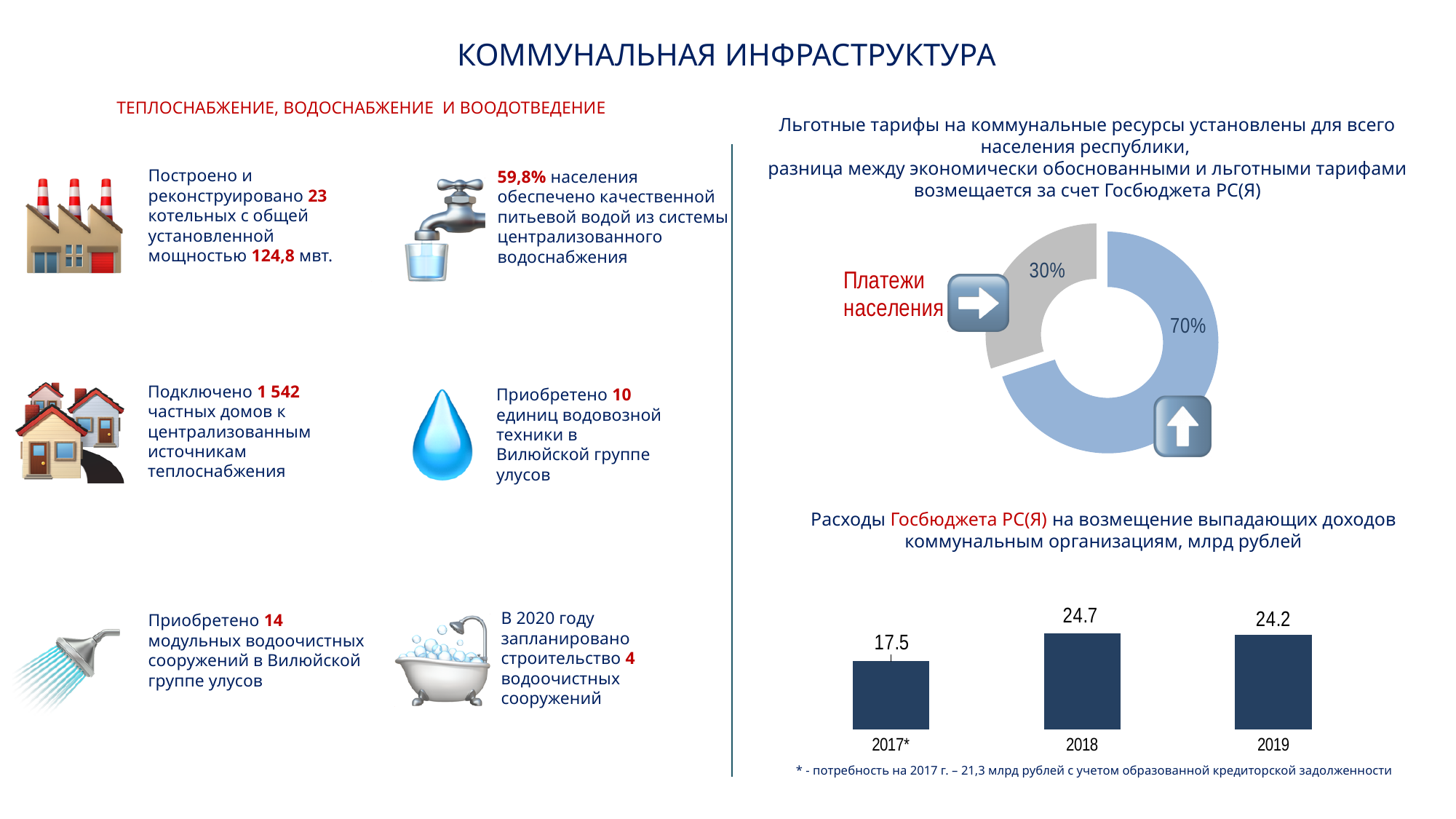
What type of chart shows the 30% and 70% split on the right side of the slide? donut (pie) chart How many bars are shown in the bar chart at the bottom right? 3 In the bar chart titled 'Расходы Госбюджета РС(Я) на возмещение выпадающих доходов коммунальным организациям, млрд рублей', what is the value for 2018? 24.7 In the bar chart at the bottom right, what is the difference between the values for 2018 and 2017*? 7.2 In the bar chart at the bottom right, what is the value for 2017*? 17.5 What type of chart is used to show 'Расходы Госбюджета РС(Я) на возмещение выпадающих доходов коммунальным организациям'? bar chart In the donut chart on the right, what share is labelled 'Платежи населения'? 30% In the bar chart at the bottom right, which year has the lowest value? 2017* In the donut chart on the right, what is the value of the larger (blue) segment? 70% In the bar chart at the bottom right, which is larger: the value for 2018 or the value for 2019? 2018 In the bar chart at the bottom right, what is the value for 2019? 24.2 In the bar chart at the bottom right, which year has the highest value? 2018